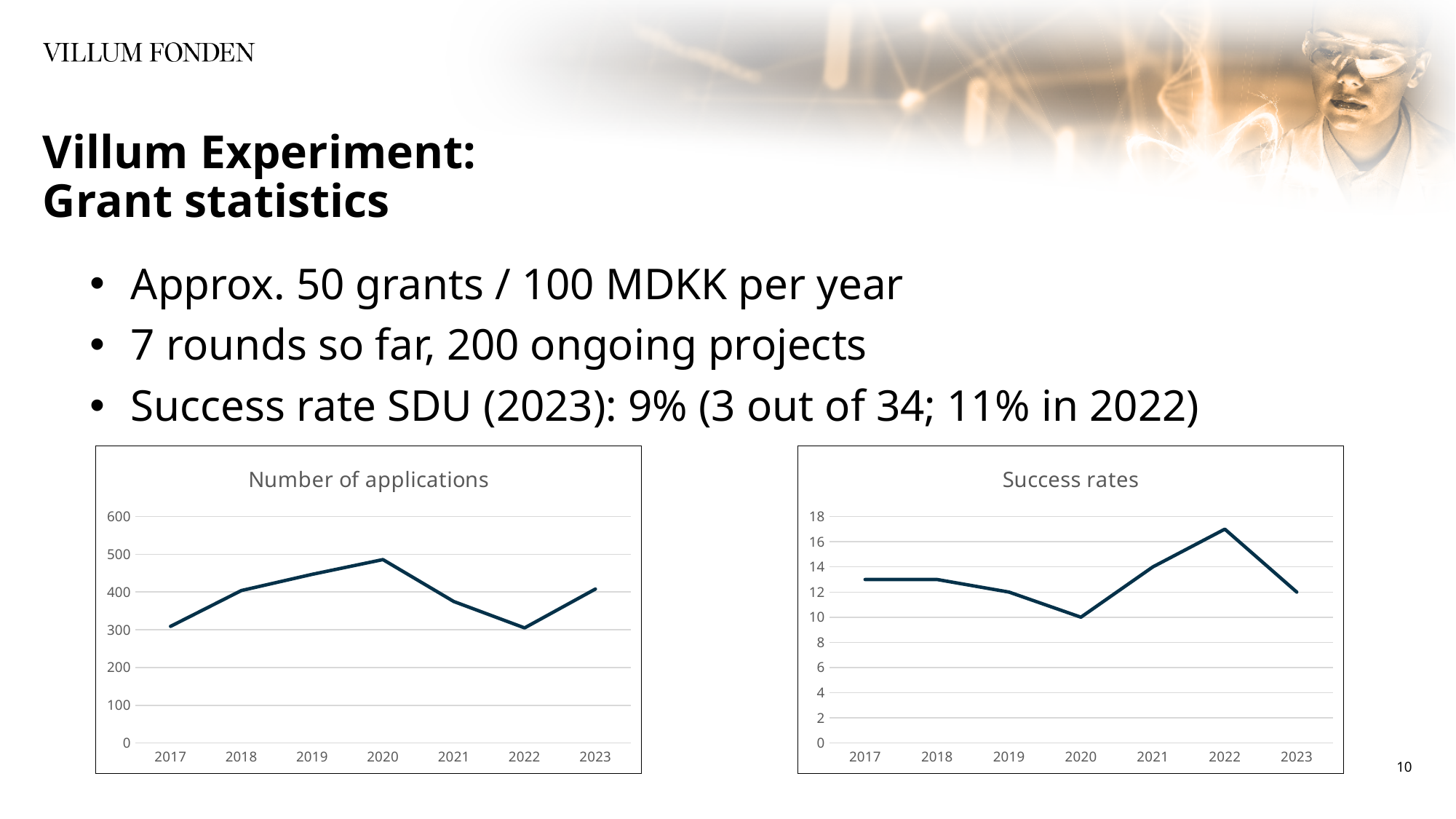
What kind of chart is the "Number of applications" chart? line chart In the "Success rates" chart, which year has the lowest success rate? 2020 In the "Success rates" chart, does the success rate rise or fall from 2022 to 2023? fall In the "Number of applications" chart, how many years are shown on the x axis? 7 In the "Number of applications" chart, is the value for 2022 greater or less than 400? less In the "Success rates" chart, which year has the highest success rate? 2022 In the "Success rates" chart, how many data points are plotted? 7 In the "Number of applications" chart, which year has the highest number of applications? 2020 In the "Success rates" chart, is the value for 2022 greater or less than 16? greater In the "Number of applications" chart, is the value for 2020 greater or less than 400? greater In the "Number of applications" chart, which year has more applications, 2018 or 2021? 2018 What kind of chart is the "Success rates" chart? line chart